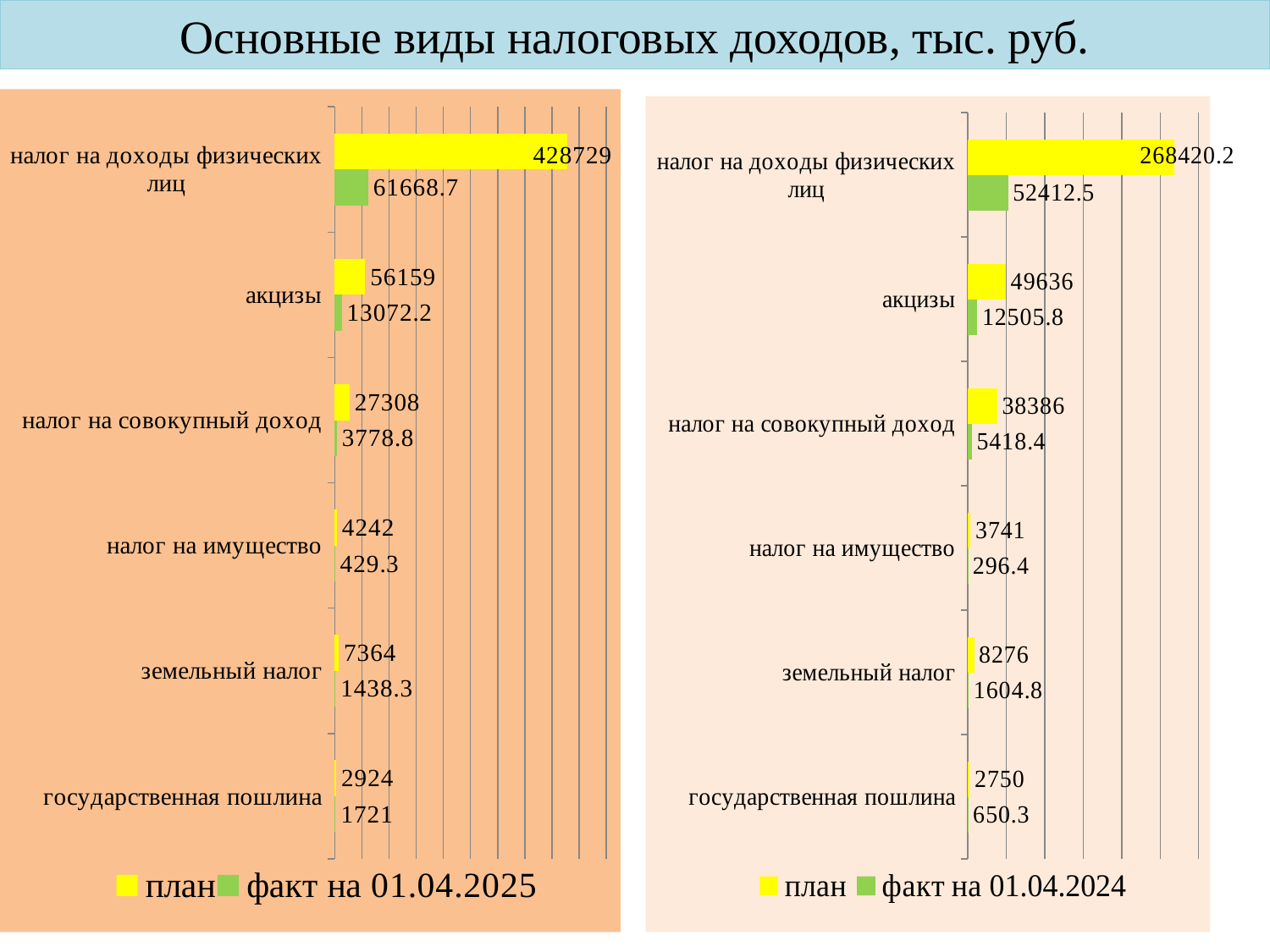
In the left chart (факт на 01.04.2025), what is the факт value for акцизы? 13072.2 How many series does the legend of the right chart (факт на 01.04.2024) list? 2 In the right chart (факт на 01.04.2024), which category has the highest факт value? налог на доходы физических лиц In the left chart (факт на 01.04.2025), what is the план value for налог на доходы физических лиц? 428729 What type of chart is the left chart (факт на 01.04.2025)? bar chart Which is larger: the факт value for государственная пошлина in the left chart (2025) or in the right chart (2024)? left chart (2025), 1721 In the right chart (факт на 01.04.2024), what is the difference between the план values for акцизы and налог на совокупный доход? 11250 In the right chart (факт на 01.04.2024), what is the факт value for налог на доходы физических лиц? 52412.5 How many categories are shown in the left chart (факт на 01.04.2025)? 6 In the left chart (факт на 01.04.2025), what is the difference between the план and факт values for налог на имущество? 3812.7 In the left chart (факт на 01.04.2025), which category has the lowest план value? государственная пошлина In the right chart (факт на 01.04.2024), what is the план value for земельный налог? 8276